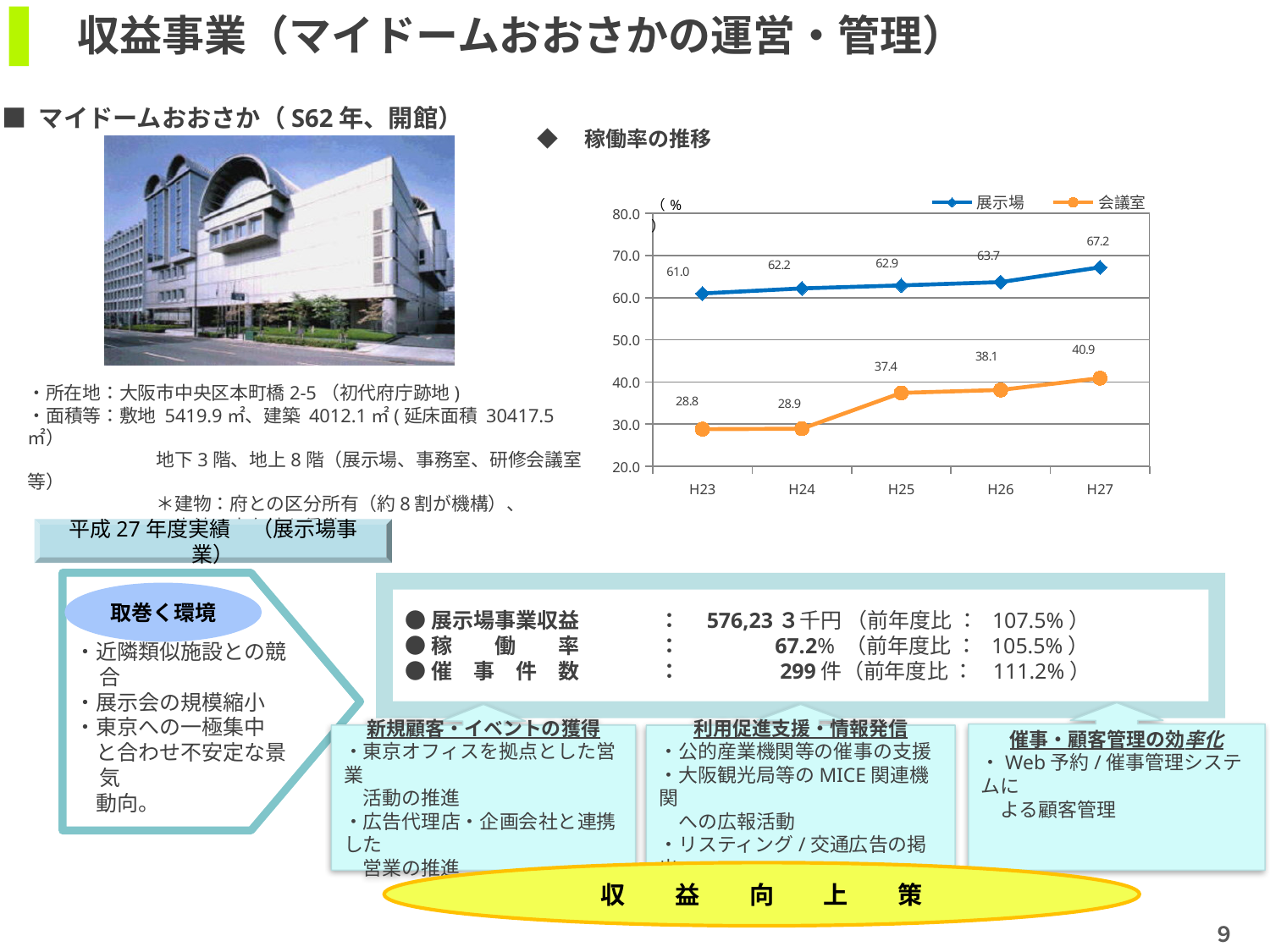
Which is larger in H26 in the 稼働率の推移 chart, 展示場 or 会議室? 展示場 In which year is the 会議室 value lowest in the 稼働率の推移 chart? H23 How many series does the legend of the 稼働率の推移 chart list? 2 What is the 展示場 value for H23 in the 稼働率の推移 chart? 61.0 What type of chart is used to show 稼働率の推移? line chart What is the 展示場 value for H27 in the 稼働率の推移 chart? 67.2 What is the difference between the 展示場 and 会議室 values for H27 in the 稼働率の推移 chart? 26.3 What is the 会議室 value for H25 in the 稼働率の推移 chart? 37.4 Does the 会議室 series rise or fall from H23 to H27 in the 稼働率の推移 chart? rise Which series in the 稼働率の推移 chart is drawn in orange? 会議室 In which year is the 展示場 value highest in the 稼働率の推移 chart? H27 How many years (categories) are plotted on the x axis of the 稼働率の推移 chart? 5